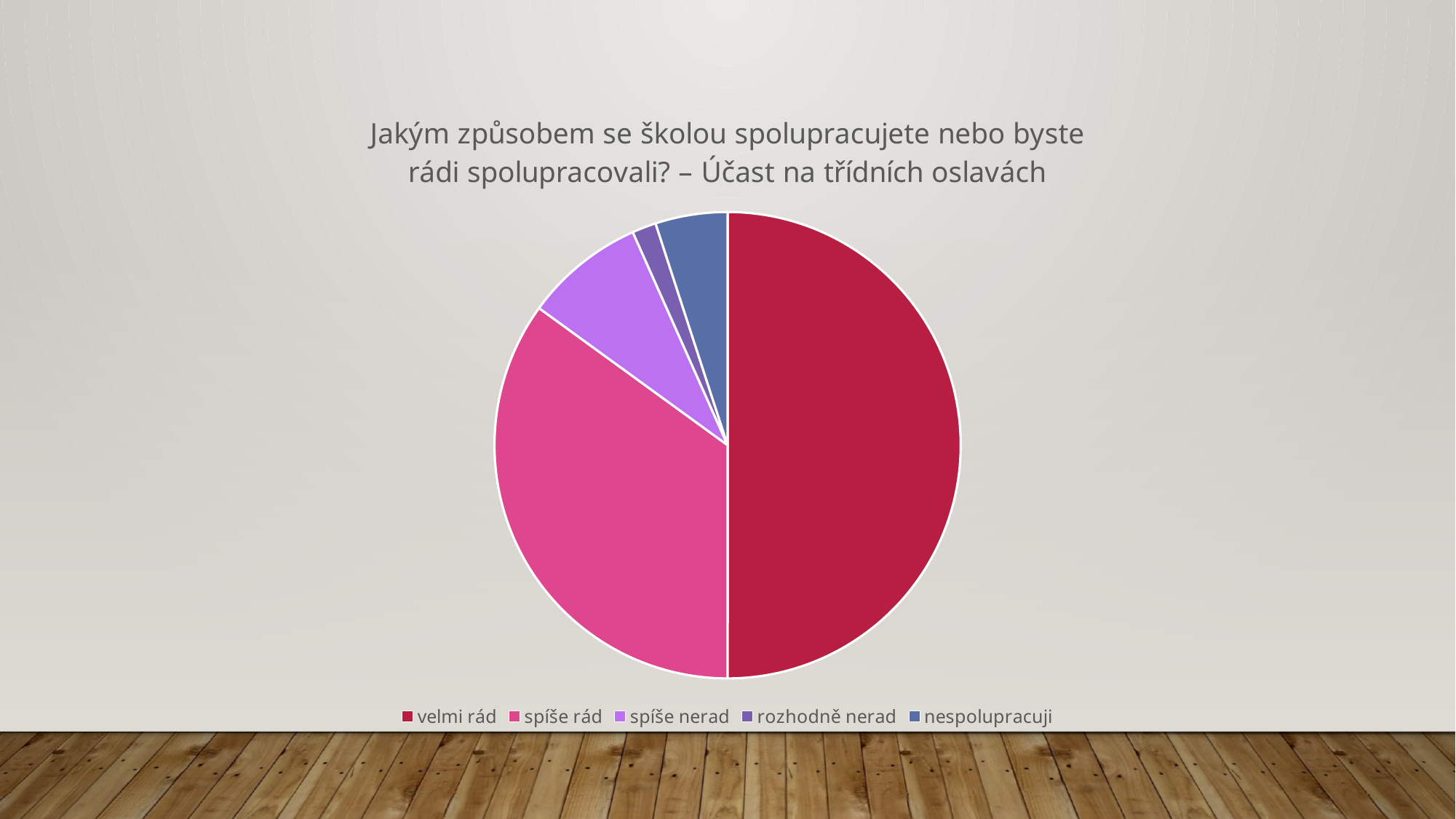
Which category has the largest slice of the pie chart? velmi rád Which slice is larger, "nespolupracuji" or "rozhodně nerad"? nespolupracuji How many entries does the legend of the pie chart list? 5 Which slice is larger, "velmi rád" or "spíše rád"? velmi rád Which slice is larger, "spíše rád" or "spíše nerad"? spíše rád How many slices does the pie chart have? 5 What kind of chart is shown on the slide? pie chart What is the title of the pie chart? Jakým způsobem se školou spolupracujete nebo byste rádi spolupracovali? – Účast na třídních oslavách Which legend entry is shown in the last (rightmost) position of the legend? nespolupracuji Which category has the smallest slice of the pie chart? rozhodně nerad